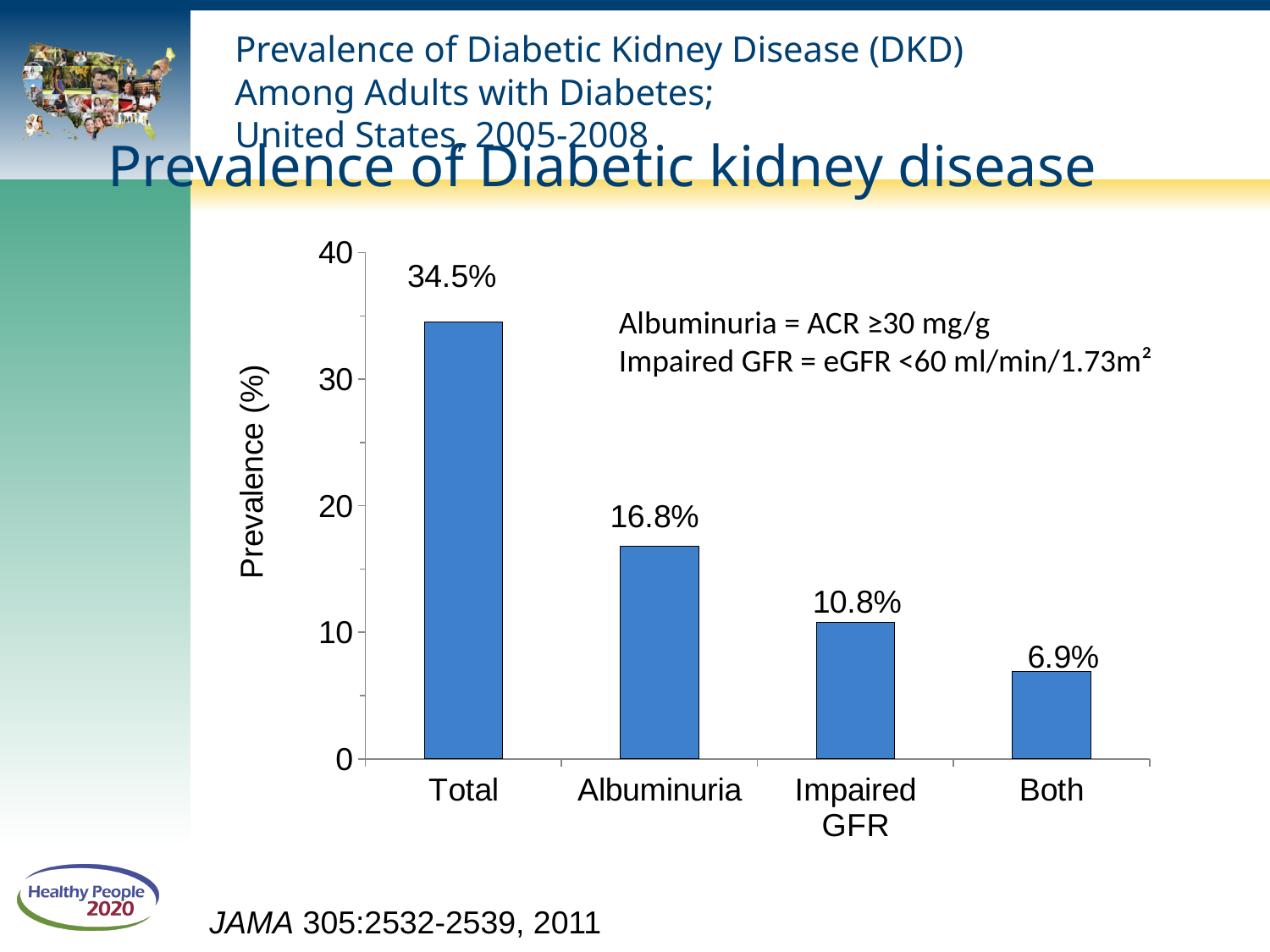
What is the difference in prevalence between Albuminuria and Impaired GFR? 6.0% What is the prevalence value shown for Albuminuria? 16.8% What is the prevalence value shown for Total? 34.5% What is the difference in prevalence between Total and Both? 27.6% What is the prevalence value shown for Impaired GFR? 10.8% Which category has the highest prevalence? Total What kind of chart is shown on the slide? Bar chart Which category has the lowest prevalence? Both How many categories are shown on the x axis? 4 Is the value for Impaired GFR greater or less than 20? less What is the prevalence value shown for Both? 6.9% Which has a larger prevalence, Albuminuria or Both? Albuminuria